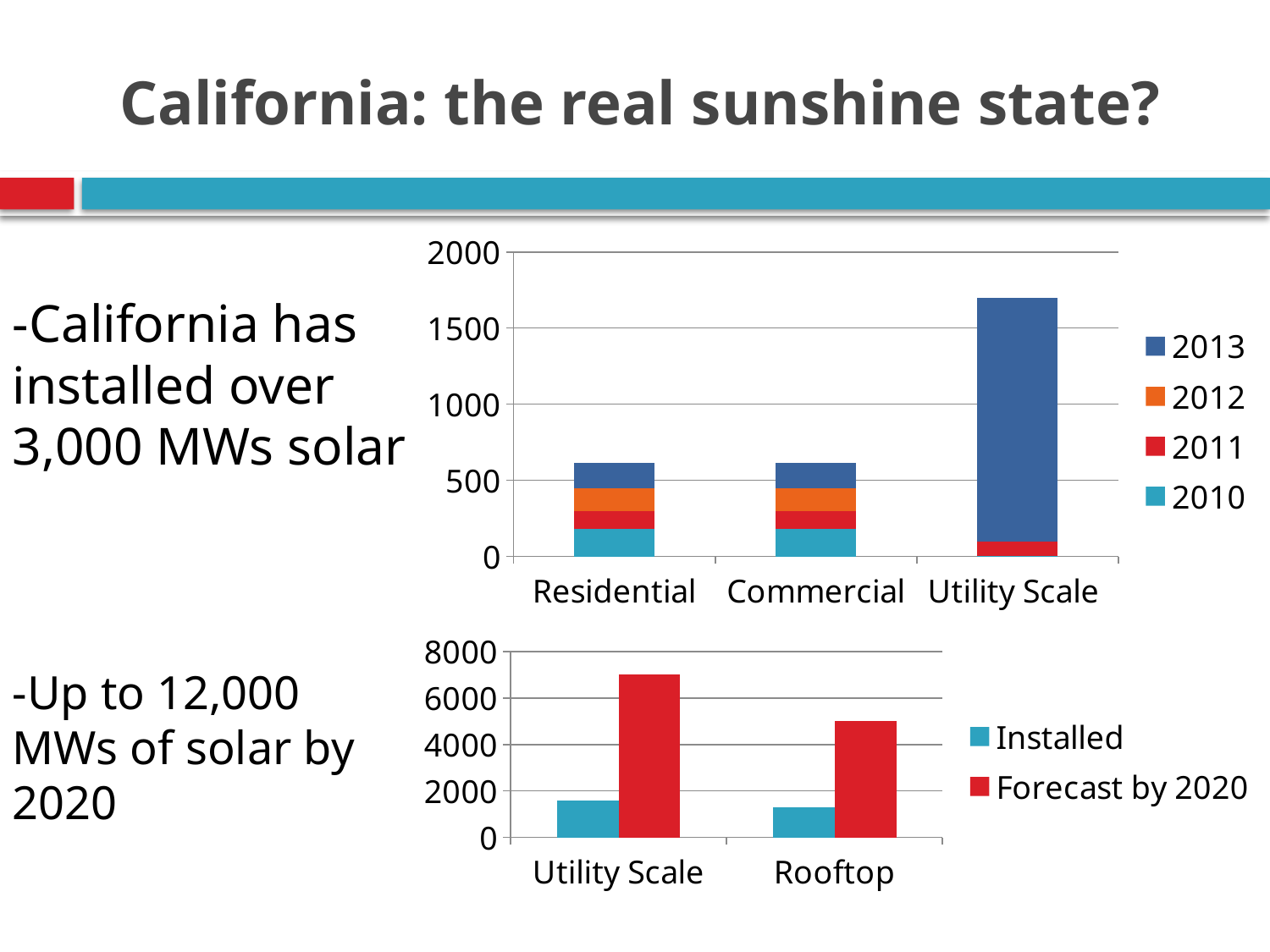
In the top chart, is the total for Residential greater or less than 1000? less In the top chart, which category has the highest total stacked bar? Utility Scale What kind of chart is the bottom chart on the slide? bar chart In the top chart, how many categories are shown on the x axis? 3 In the bottom chart, which category has the larger Forecast by 2020 value, Utility Scale or Rooftop? Utility Scale In the bottom chart, is the Forecast by 2020 value for Utility Scale greater or less than 6000? greater In the bottom chart, how many categories are shown on the x axis? 2 In the top chart, how many series does the legend list? 4 In the bottom chart, how many series does the legend list? 2 In the top chart, is the total for Utility Scale greater or less than 1500? greater What kind of chart is the top chart on the slide? stacked bar chart In the top chart, which series is shown in dark blue? 2013